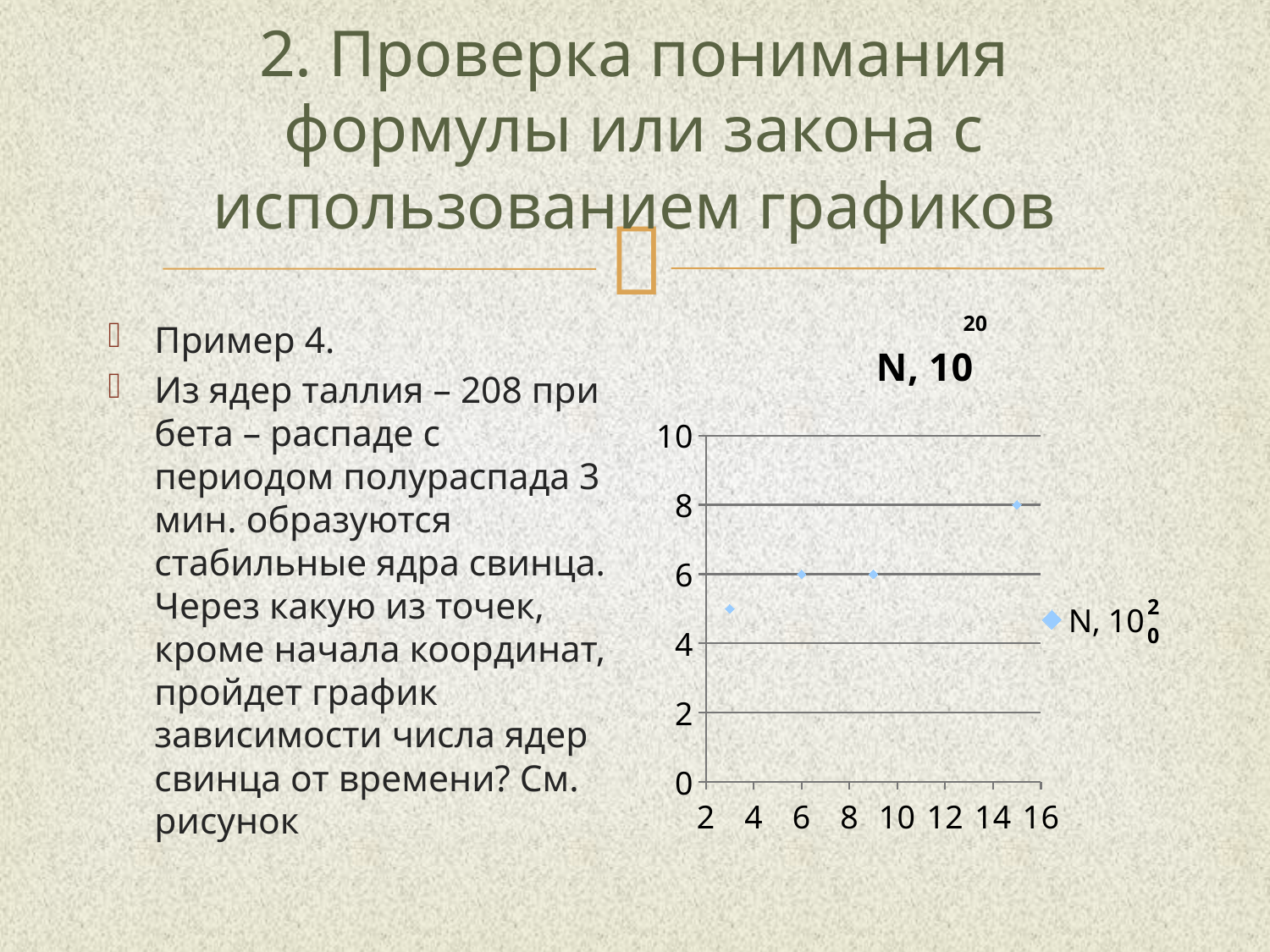
Which point has the highest y value: the leftmost point or the rightmost point? the rightmost point What is the highest value shown on the y axis? 10 How many data points are plotted on the chart? 4 Do the y values of the points generally rise or fall as x increases? rise What is the y value of the rightmost point on the chart? 8 What is the y value of the point at x = 6? 6 Is the y value of the rightmost point greater or less than 10? less How many series does the legend list? 1 What kind of chart is shown on the slide? scatter chart Is the y value of the leftmost point greater or less than 6? less What is the title of the chart? N, 10^20 Is the y value of the leftmost point greater or less than 4? greater